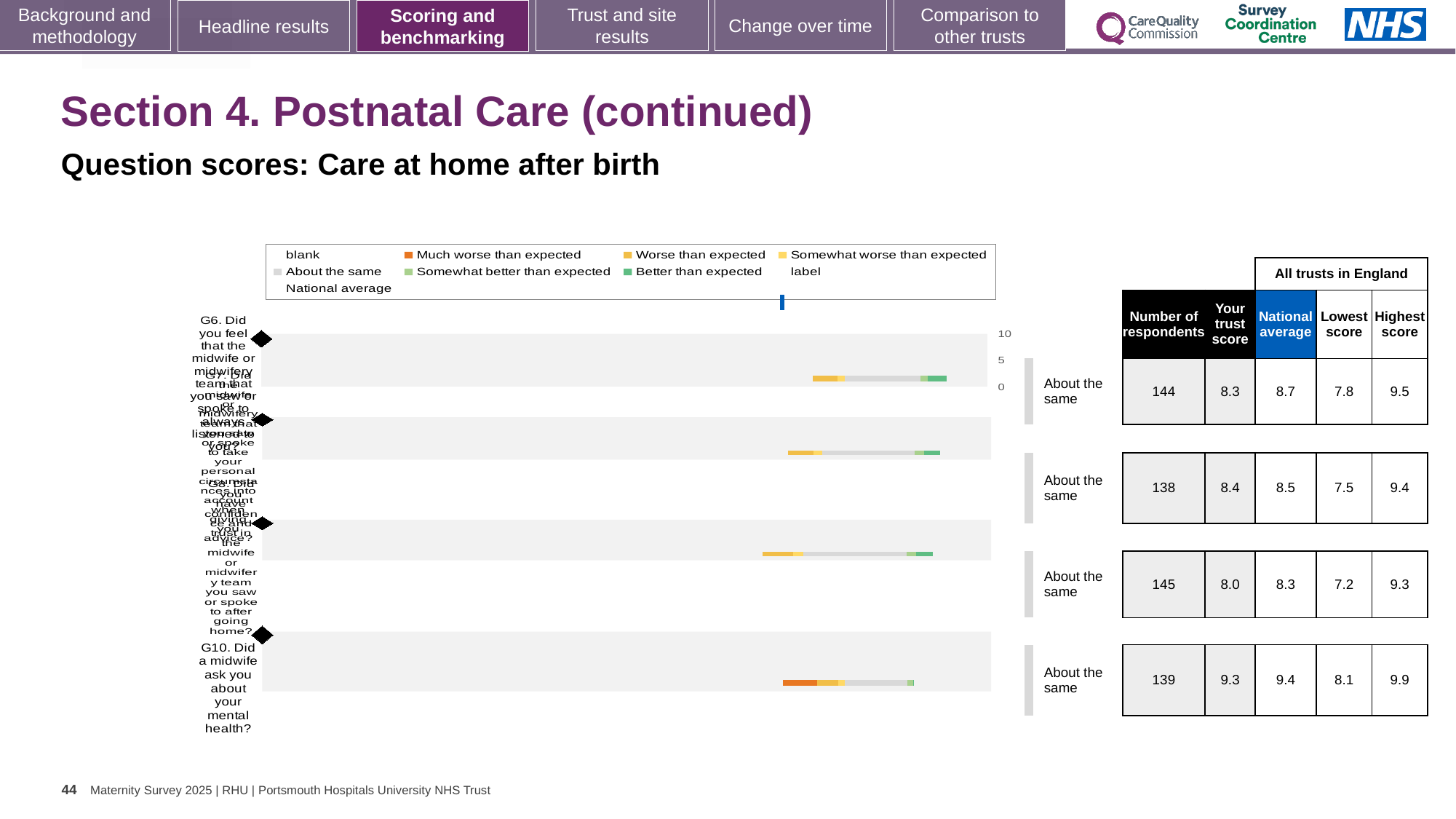
In the table next to the chart, what is the number of respondents for G10 (Did a midwife ask you about your mental health?)? 139 What is the difference between the trust scores for G10 and G6 in the table? 1.0 What benchmark category is shown beside each bar in the chart? About the same In the table next to the chart, what is the trust score for G10 (Did a midwife ask you about your mental health?)? 9.3 In the table next to the chart, what is the national average for G10 (Did a midwife ask you about your mental health?)? 9.4 In the table next to the chart, what is the highest score among all trusts in England for G10? 9.9 In the table next to the chart, what is the trust score for the first question, G6? 8.3 How many question bars are plotted in the chart? 4 What is the chart's subtitle describing the question scores? Care at home after birth In the table next to the chart, what is the lowest score among all trusts in England for the first question, G6? 7.8 What kind of chart is shown on the slide? bar chart Which has the higher trust score in the table: G6 or G10? G10